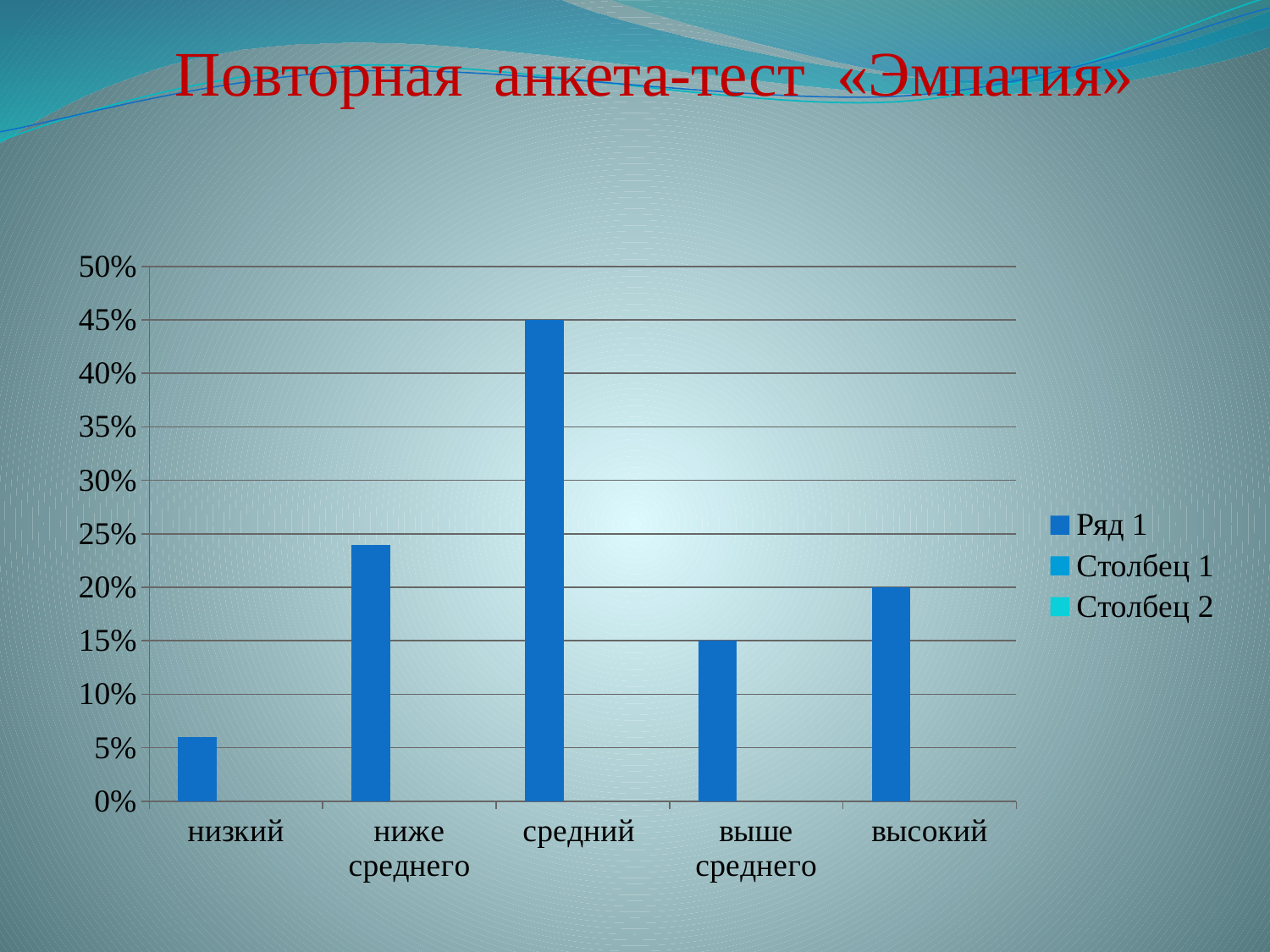
What is the difference between the values for 'средний' and 'высокий'? 25% What is the value for the category 'высокий'? 20% How many entries does the chart's legend list? 3 What type of chart is shown on the slide? bar chart Is the value for 'низкий' greater or less than 5%? greater What is the value for the category 'средний'? 45% Is the value for 'ниже среднего' greater or less than 25%? less Which category has the lowest value in the chart? низкий Which is larger, the value for 'ниже среднего' or the value for 'высокий'? ниже среднего Which category has the highest value in the chart? средний How many categories are shown on the x axis of the chart? 5 What is the value for the category 'выше среднего'? 15%